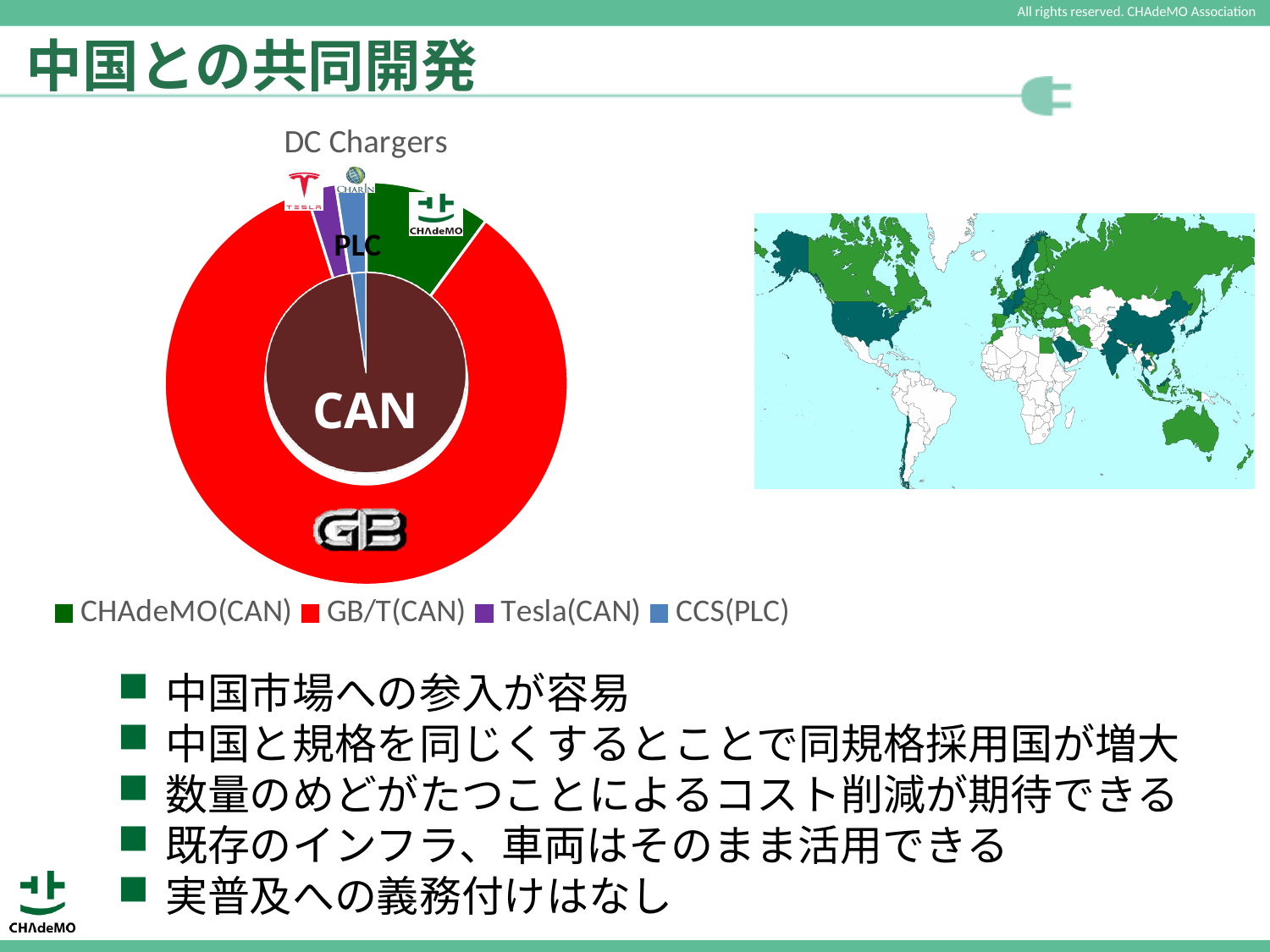
How many categories does the legend of the DC Chargers pie chart list? 4 In the DC Chargers pie chart, which slice is larger: GB/T(CAN) or CCS(PLC)? GB/T(CAN) What kind of chart is shown on the slide? doughnut chart In the DC Chargers pie chart, which slice is larger: CHAdeMO(CAN) or Tesla(CAN)? CHAdeMO(CAN) Which legend entry in the DC Chargers pie chart is the only one labelled PLC rather than CAN? CCS(PLC) What colour is the GB/T(CAN) slice in the DC Chargers pie chart? red What is the title of the pie chart? DC Chargers In the DC Chargers pie chart, which slice is larger: GB/T(CAN) or CHAdeMO(CAN)? GB/T(CAN) Which category has the largest slice in the DC Chargers pie chart? GB/T(CAN)